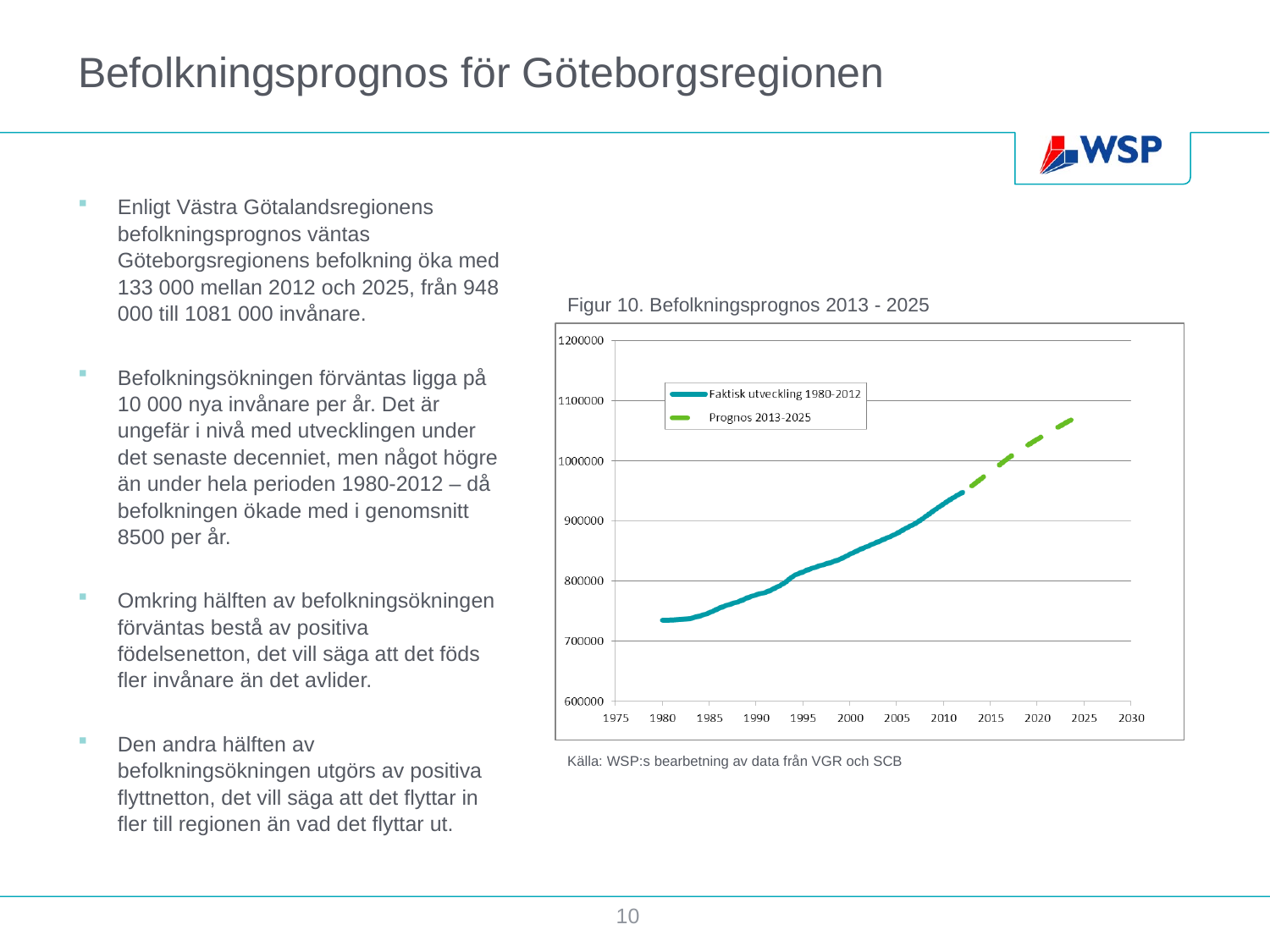
In Figur 10, is the forecast value for 2025 greater or less than 1000000? greater Does the population in Figur 10 rise or fall from 1980 to 2025? rise In Figur 10, is the value for 1980 greater or less than 700000? greater What are the two series named in the legend of Figur 10? Faktisk utveckling 1980-2012 and Prognos 2013-2025 In Figur 10, is the value for 2012 greater or less than 1000000? less What kind of chart is shown in Figur 10? line chart How many series does the legend of Figur 10 list? 2 What is the title of the chart on the slide? Figur 10. Befolkningsprognos 2013 - 2025 In Figur 10, which series reaches the highest value on the chart? Prognos 2013-2025 In Figur 10, which is larger, the value for 1990 or the value for 2010? 2010